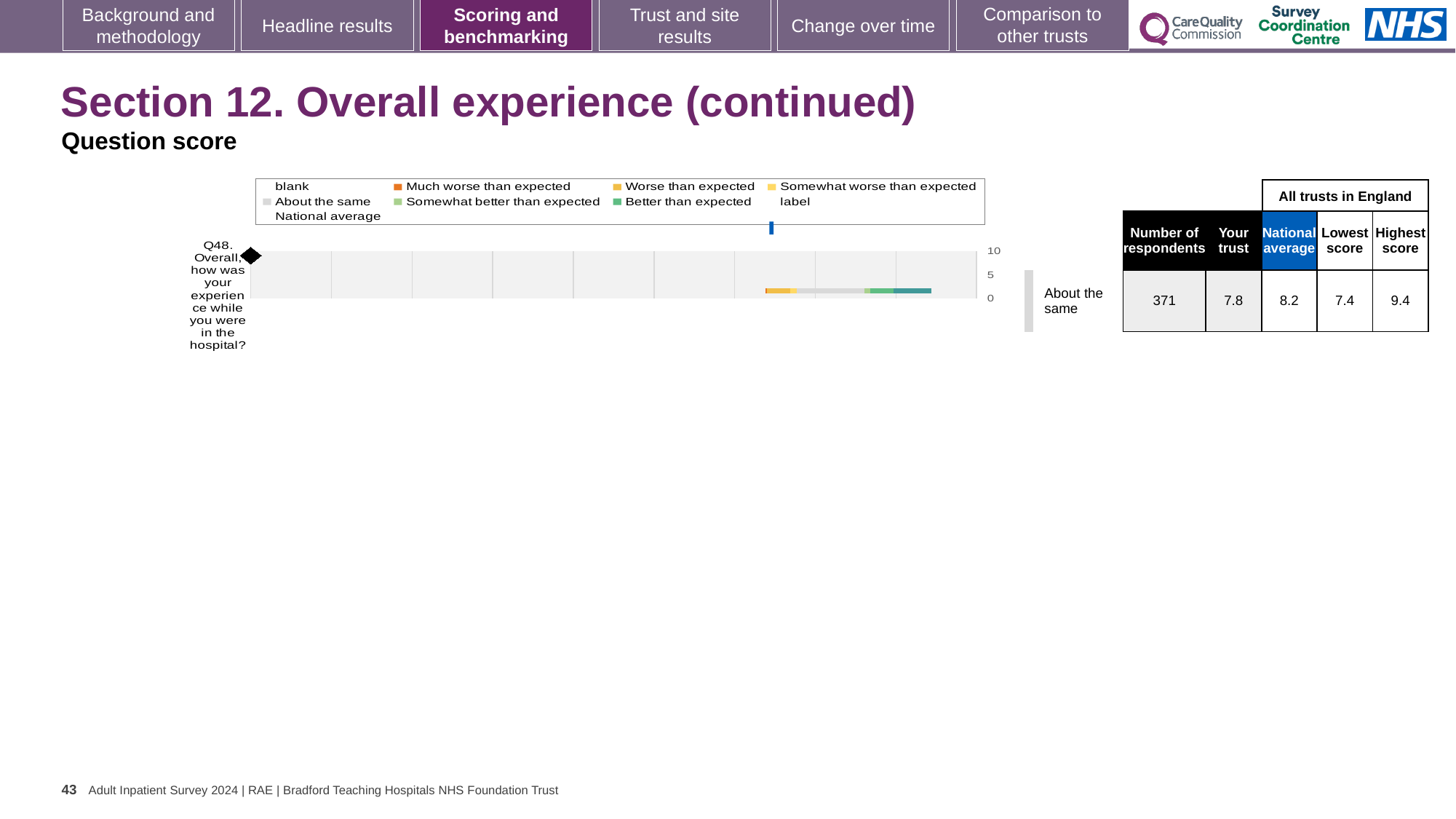
What is the national average score for Q48? 8.2 Which question is plotted on the question score chart? Q48. Overall, how was your experience while you were in the hospital? What benchmark category is the trust's Q48 score placed in? About the same What is the highest score among all trusts in England for Q48? 9.4 What kind of chart is used to show the Q48 question score? bar chart What is the lowest score among all trusts in England for Q48? 7.4 Which is larger for Q48, the 'Your trust' score or the national average? National average What is the 'Your trust' score for Q48? 7.8 How many respondents answered Q48? 371 What is the difference between the national average and the 'Your trust' score for Q48? 0.4 What is the difference between the highest score and the lowest score for Q48? 2.0 How many questions are plotted on the question score chart? 1